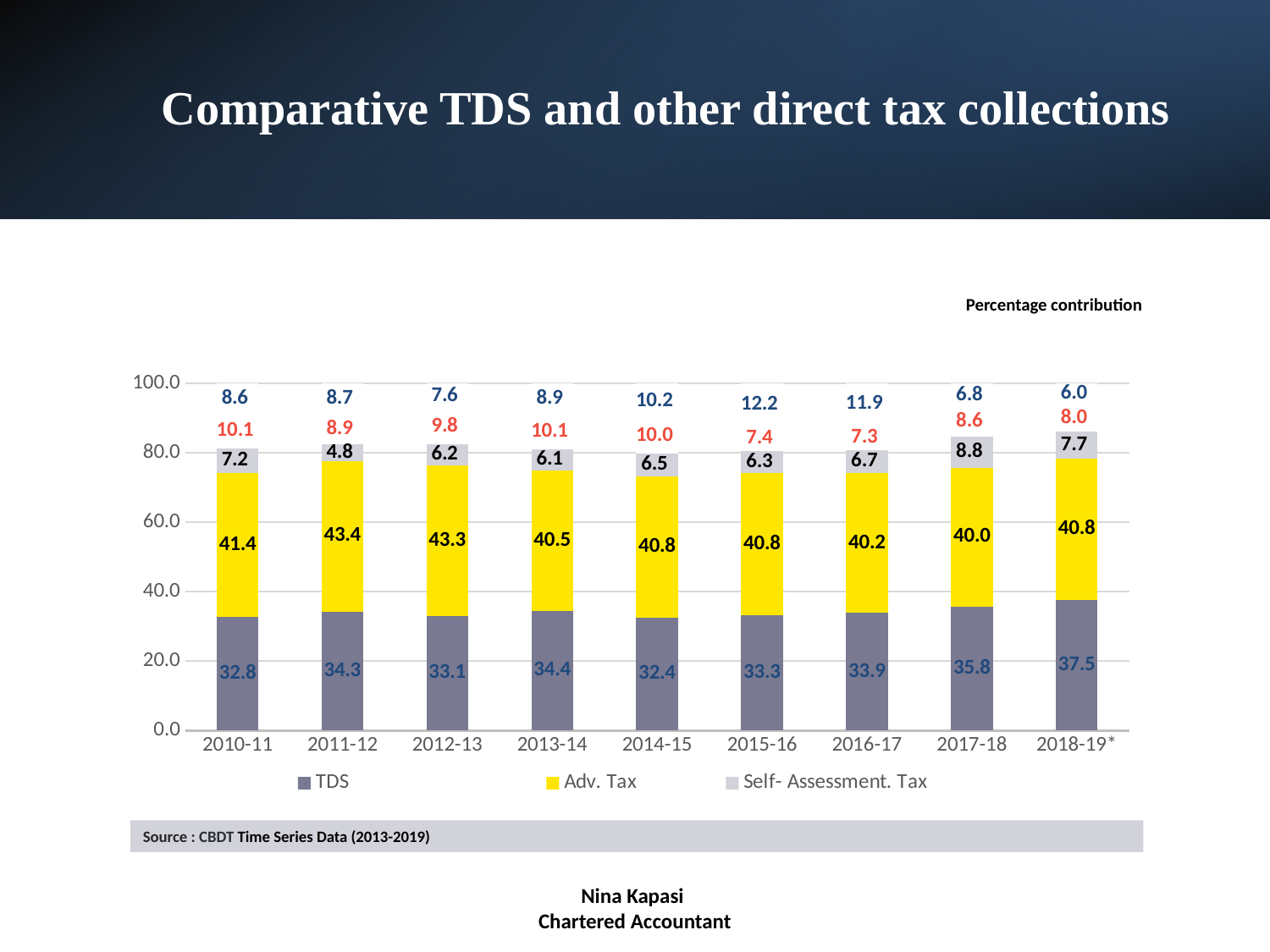
In which year is the TDS value highest? 2018-19* How many years are shown on the x axis? 9 What is the Adv. Tax value for 2012-13? 43.3 In which year is the Self- Assessment. Tax value lowest? 2011-12 Which is larger, the TDS value for 2017-18 or for 2016-17? 2017-18 What is the difference between the Adv. Tax and TDS values in 2010-11? 8.6 What is the TDS value for 2018-19*? 37.5 What is the Self- Assessment. Tax value for 2017-18? 8.8 What kind of chart is shown on the slide? Stacked bar chart What is the combined total of TDS, Adv. Tax and Self- Assessment. Tax for 2011-12? 82.5 How many series does the legend list? 3 In which year is the TDS value lowest? 2014-15